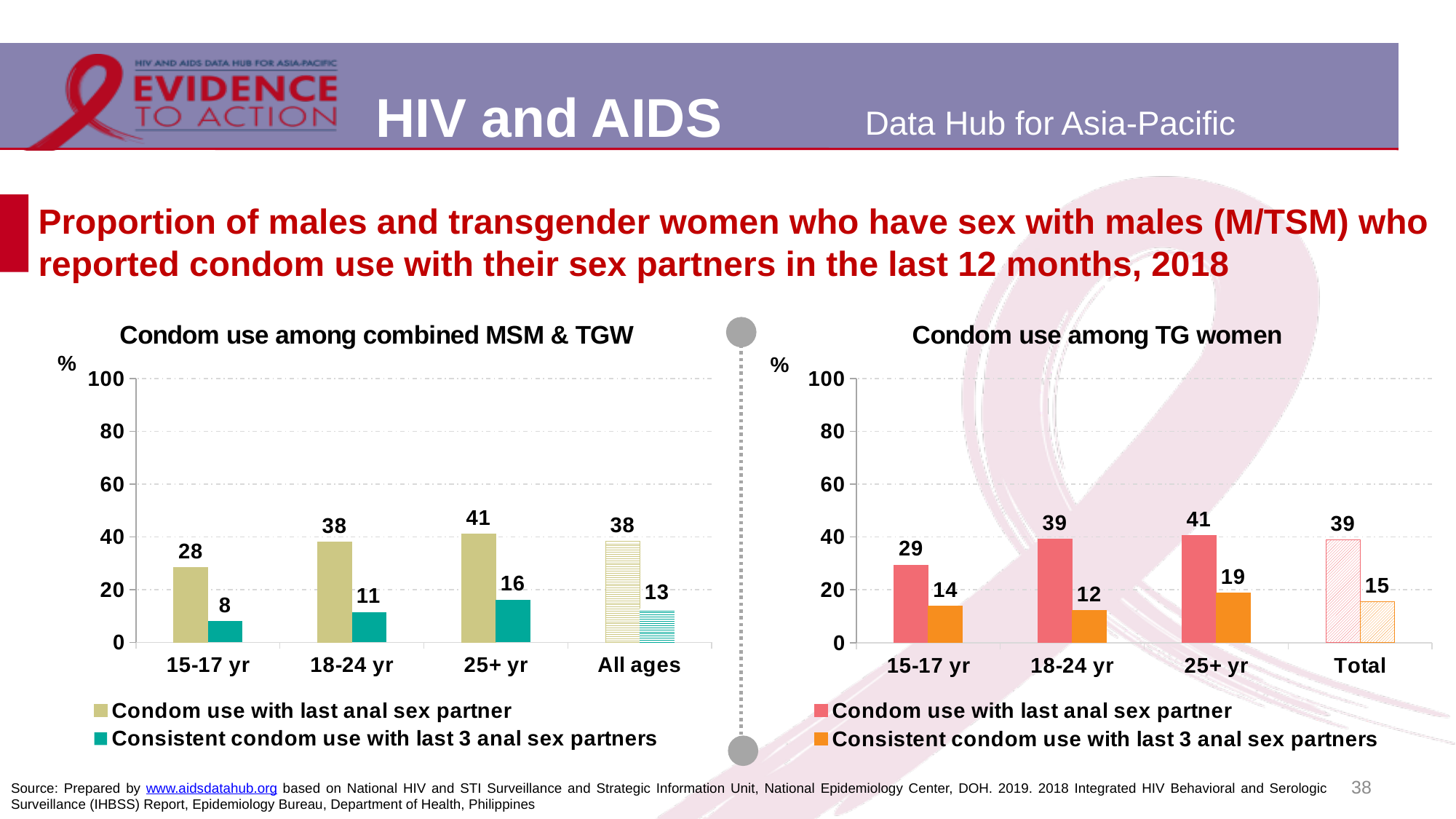
What kind of chart is the 'Condom use among combined MSM & TGW' chart? Bar chart How many series does the legend of the 'Condom use among TG women' chart list? 2 In the 'Condom use among TG women' chart, what is the value for consistent condom use with last 3 anal sex partners for the 25+ yr group? 19 In the 'Condom use among TG women' chart, which is larger: condom use with last anal sex partner for 15-17 yr or for 18-24 yr? 18-24 yr In the 'Condom use among combined MSM & TGW' chart, what is the value for condom use with last anal sex partner for the 15-17 yr group? 28 In the 'Condom use among TG women' chart, is the value for condom use with last anal sex partner for the Total group greater or less than 60? less In the 'Condom use among combined MSM & TGW' chart, what is the difference between condom use with last anal sex partner and consistent condom use with last 3 anal sex partners for the 18-24 yr group? 27 In the 'Condom use among TG women' chart, which age group has the lowest value for consistent condom use with last 3 anal sex partners? 18-24 yr How many categories are shown on the x axis of the 'Condom use among combined MSM & TGW' chart? 4 What is the title of the chart on the right side of the slide? Condom use among TG women In the 'Condom use among combined MSM & TGW' chart, which age group has the highest value for condom use with last anal sex partner? 25+ yr In the 'Condom use among TG women' chart, does consistent condom use with last 3 anal sex partners rise or fall from 18-24 yr to 25+ yr? Rise